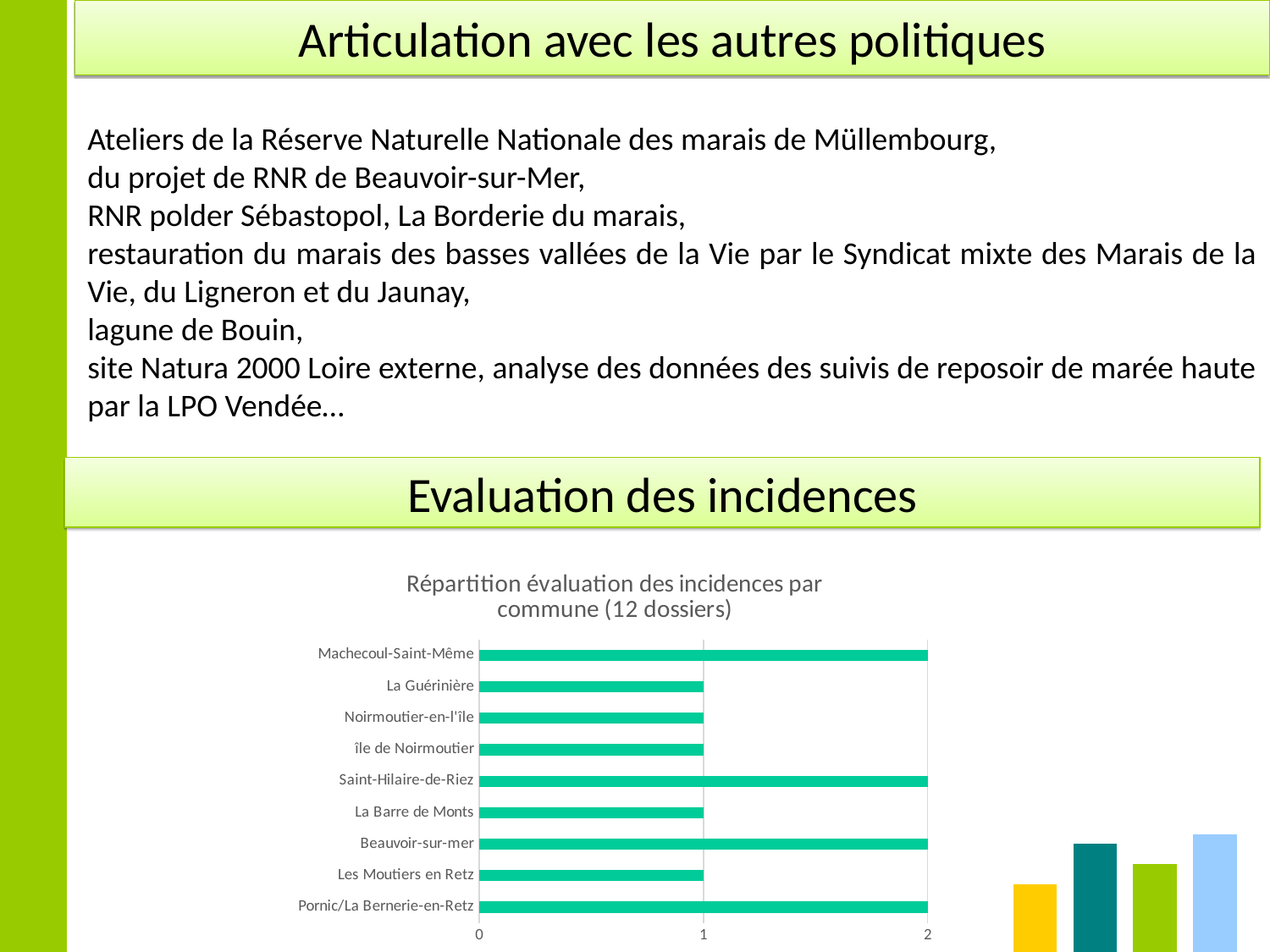
What is the difference between the values for Machecoul-Saint-Même and Noirmoutier-en-l'île? 1 What is the highest value shown on the horizontal axis of the chart? 2 What is the title of the chart on the slide? Répartition évaluation des incidences par commune (12 dossiers) What is the value for La Guérinière? 1 What is the value for Machecoul-Saint-Même? 2 What is the value for Pornic/La Bernerie-en-Retz? 2 What type of chart is shown under 'Evaluation des incidences'? bar chart How many communes (categories) are listed in the chart? 9 What is the value for Saint-Hilaire-de-Riez? 2 How many communes have a value of 2 in the chart? 4 Which has a larger value, Beauvoir-sur-mer or La Barre de Monts? Beauvoir-sur-mer What is the value for Les Moutiers en Retz? 1